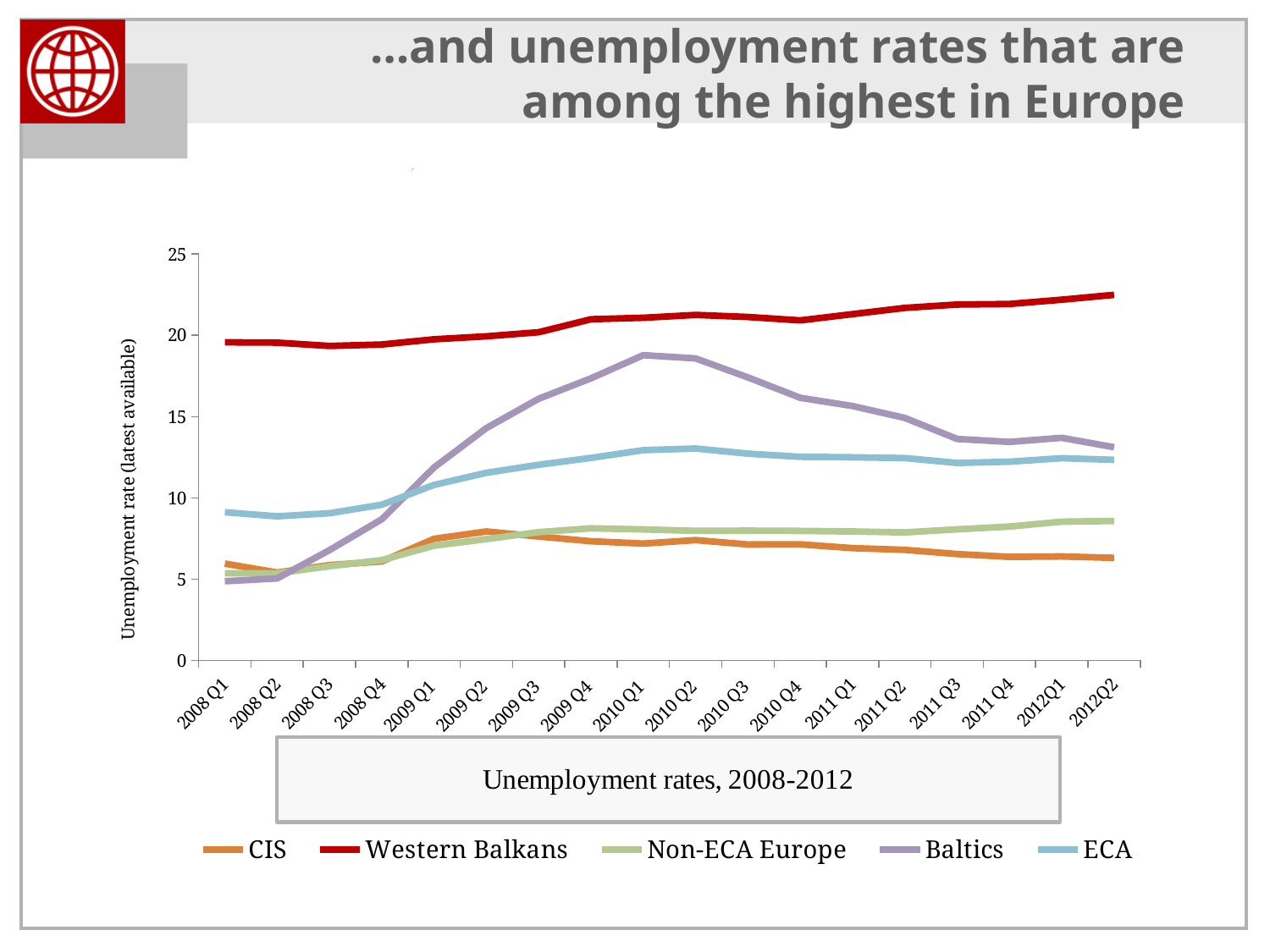
What kind of chart is shown on the slide? line chart Which series has the lowest unemployment rate in 2012Q2? CIS Does the Western Balkans unemployment rate generally rise or fall from 2008 Q1 to 2012Q2? rise What is the label on the y axis of the chart? Unemployment rate (latest available) Is the unemployment rate for ECA in 2010 Q2 greater or less than 10? greater Which series has a higher unemployment rate in 2010 Q1, Baltics or ECA? Baltics How many series does the legend list? 5 Which series has the highest unemployment rate in 2012Q2? Western Balkans How many quarters are shown along the x axis? 18 What is the title shown in the box below the chart? Unemployment rates, 2008-2012 Is the unemployment rate for Western Balkans in 2012Q2 greater or less than 20? greater